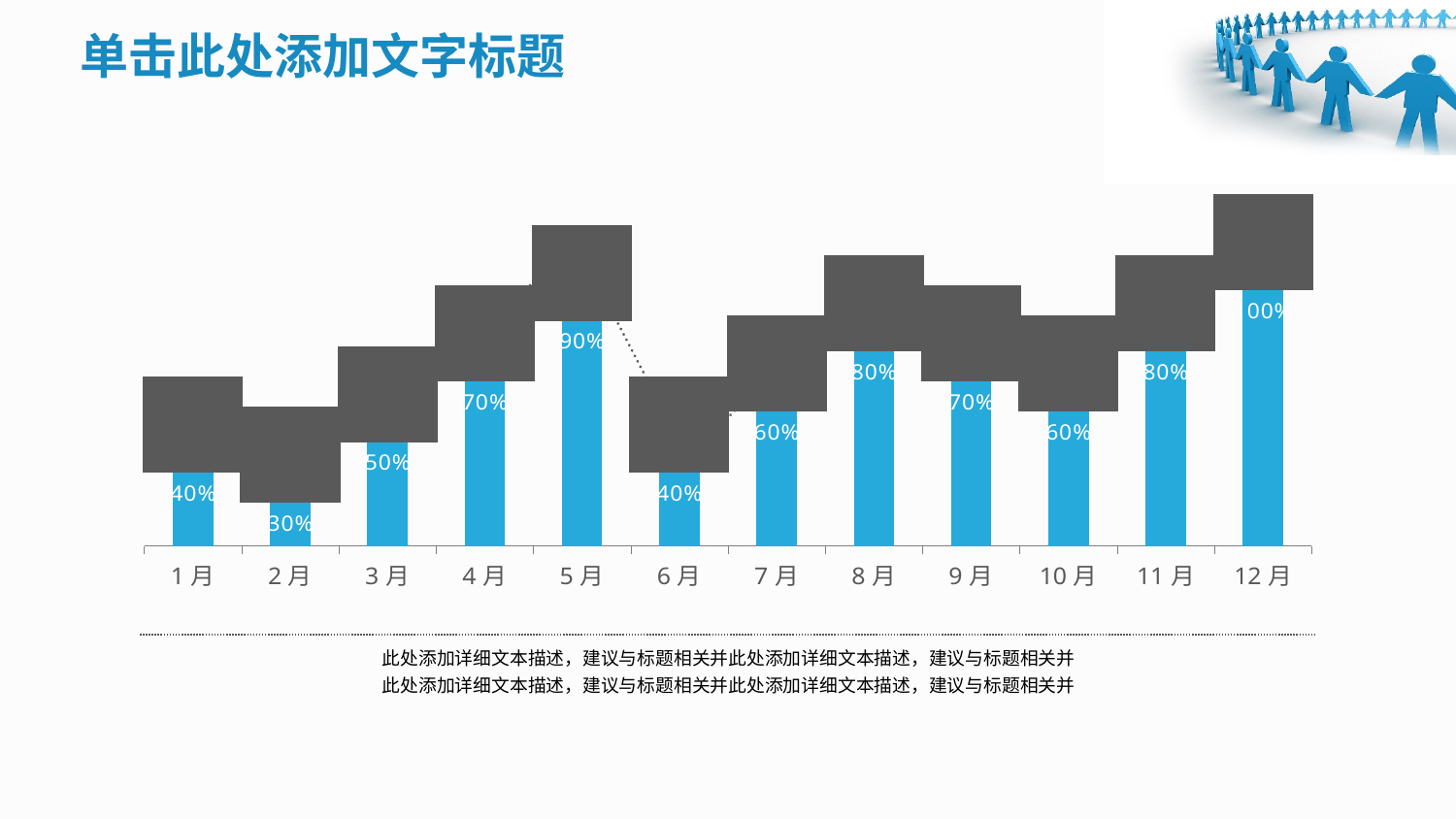
What is the value for 10 月? 60% Do the values rise or fall from 6 月 to 8 月? Rise How many months are shown on the x axis? 12 What is the value for 5 月? 90% Which month has the highest value? 12 月 Which month has the lowest value? 2 月 What is the value for 8 月? 80% Which is larger, the value for 4 月 or the value for 7 月? 4 月 What is the value for 1 月? 40% What kind of chart is shown on the slide? Bar chart What colour are the bars in the chart? Blue What is the difference between the values for 5 月 and 1 月? 50%